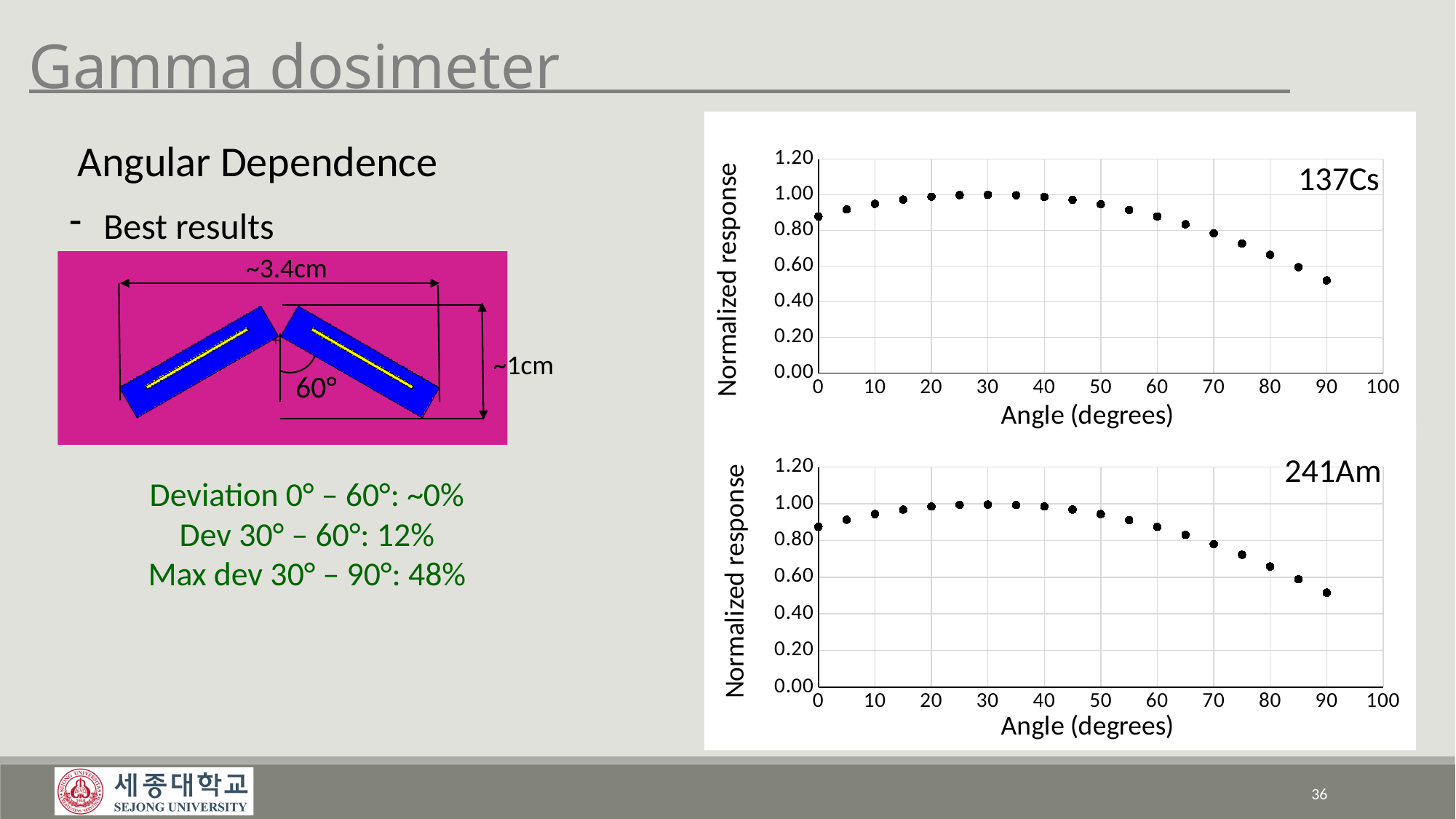
What is the x-axis label of the 241Am chart? Angle (degrees) In the 241Am chart, at which angle is the normalized response lowest? 90 In the 137Cs chart, does the normalized response rise or fall between 40 and 90 degrees? fall In the 241Am chart, is the normalized response at 0 degrees greater or less than 0.80? greater In the 137Cs chart, at which angle is the normalized response lowest? 90 What is the y-axis label of the 137Cs chart? Normalized response What kind of chart is the top chart labelled 137Cs? scatter chart In the 137Cs chart, is the normalized response at 80 degrees greater or less than 0.80? less In the 137Cs chart, how many data points are plotted? 19 In the 241Am chart, how many data points are plotted? 19 In the 137Cs chart, is the normalized response at 90 degrees greater or less than 0.60? less In the 241Am chart, which has the larger normalized response: 0 degrees or 90 degrees? 0 degrees